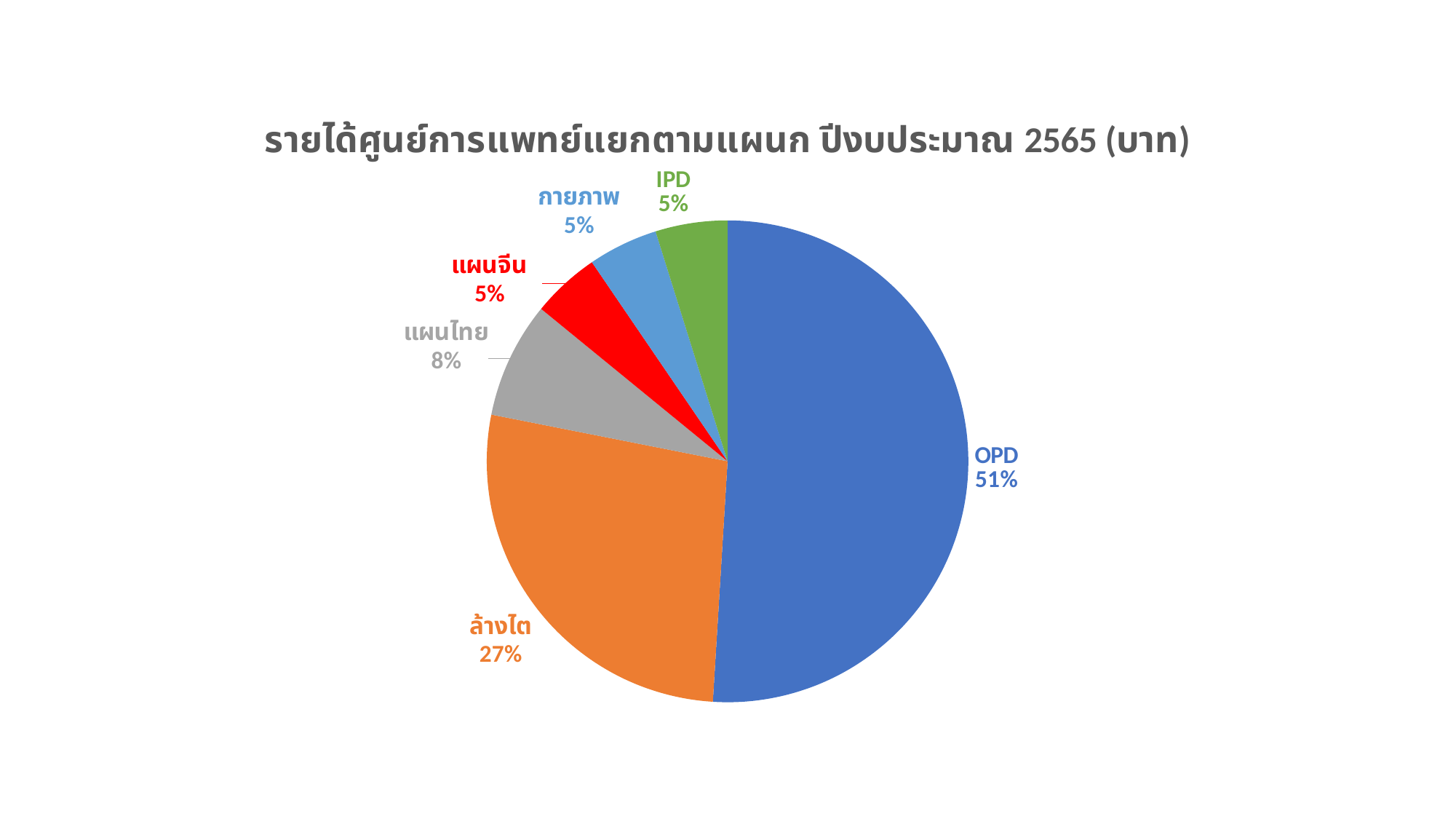
Which category has the largest slice of the pie? OPD What colour is the OPD slice? blue What share of the pie does OPD have? 51% What share of the pie does ล้างไต have? 27% What share of the pie does แผนไทย have? 8% How many slices does the pie chart have? 6 What is the difference in percentage points between the OPD share and the ล้างไต share? 24 What is the title of the chart? รายได้ศูนย์การแพทย์แยกตามแผนก ปีงบประมาณ 2565 (บาท) What kind of chart is shown on the slide? pie chart Which is larger, the share for ล้างไต or the share for แผนไทย? ล้างไต